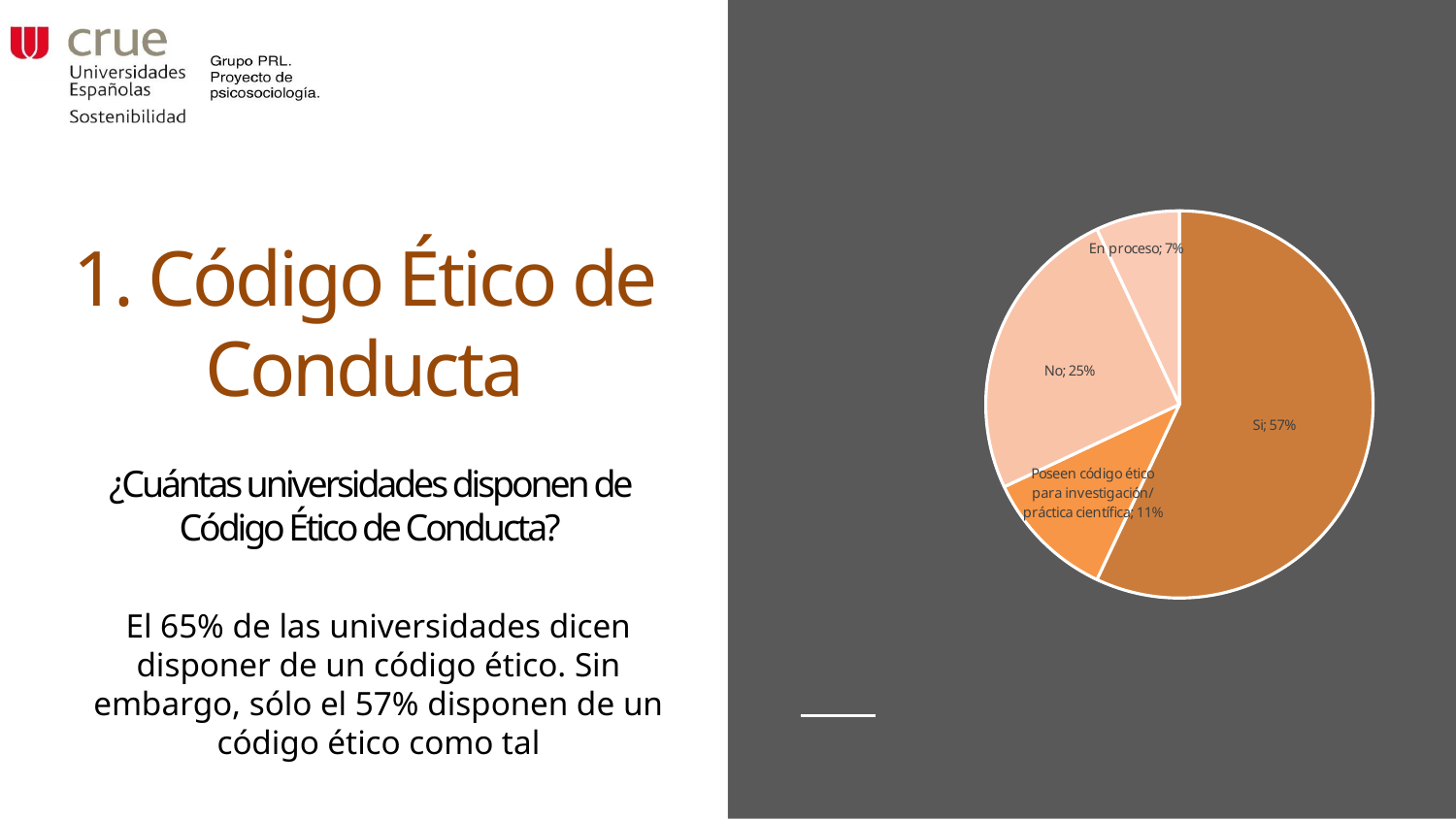
Which is larger, the "No" slice or the "Poseen código ético para investigación/práctica científica" slice? No What share of the pie does the "Si" slice represent? 57% What share of the pie does the "No" slice represent? 25% What is the difference in percentage points between the "Poseen código ético para investigación/práctica científica" slice and the "En proceso" slice? 4 How many slices does the pie chart have? 4 Which slice of the pie chart is the largest? Si What share of the pie does the "Poseen código ético para investigación/práctica científica" slice represent? 11% Which slice of the pie chart is the smallest? En proceso What is the difference in percentage points between the "Si" slice and the "No" slice? 32 What kind of chart is shown on the slide? pie chart Is the "Si" slice greater or less than 50% of the pie? greater